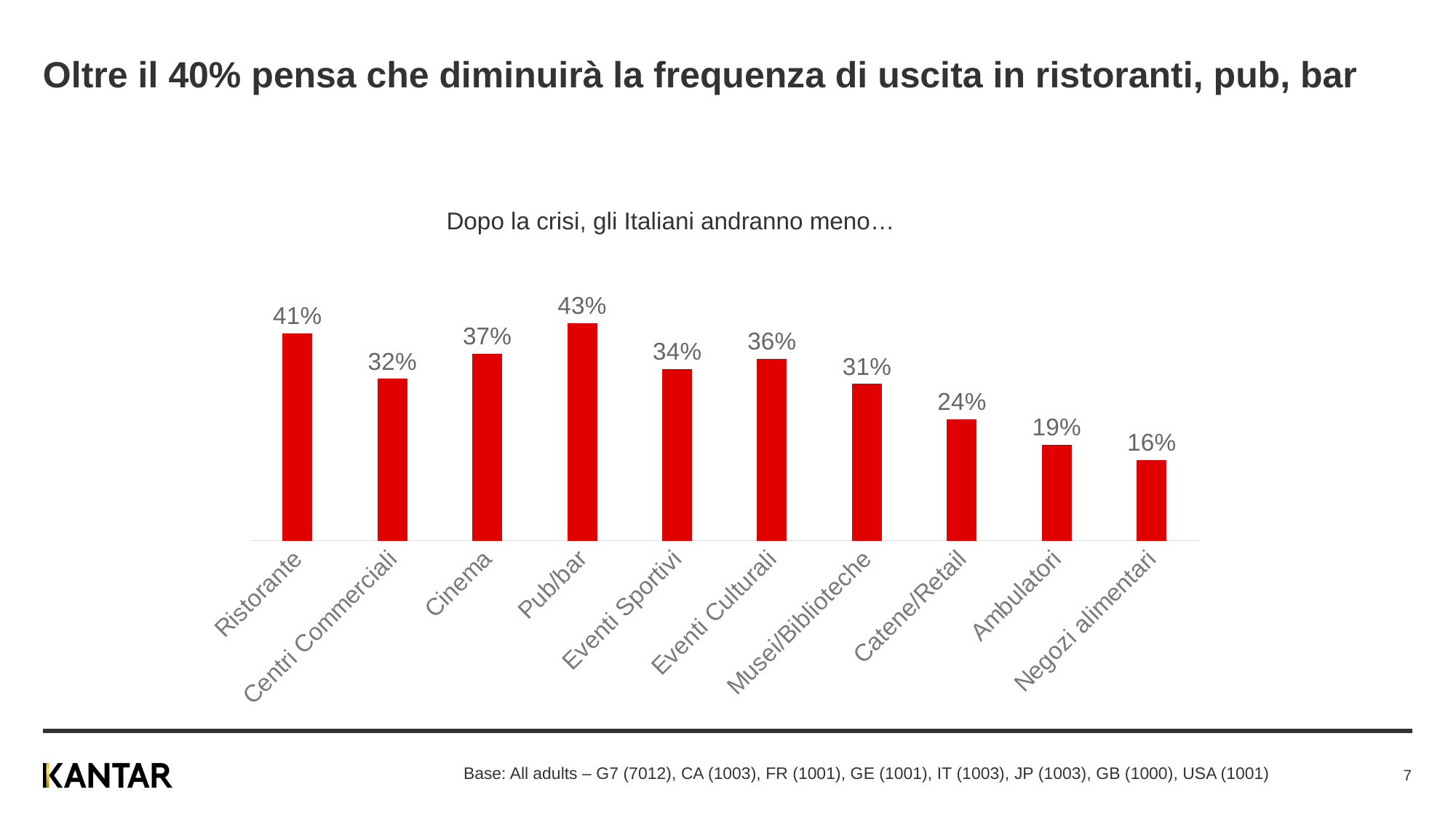
What colour are the bars in the chart? Red Which category has the highest value? Pub/bar What kind of chart is shown on the slide? Bar chart What is the difference between the values for Catene/Retail and Ambulatori? 5% What is the value for Negozi alimentari? 16% Which is larger, the value for Cinema or the value for Eventi Culturali? Cinema What is the value for Musei/Biblioteche? 31% Which category has the lowest value? Negozi alimentari How many categories are shown in the chart? 10 What is the difference between the values for Ristorante and Centri Commerciali? 9% What is the title of the chart? Dopo la crisi, gli Italiani andranno meno… What is the value for Pub/bar? 43%